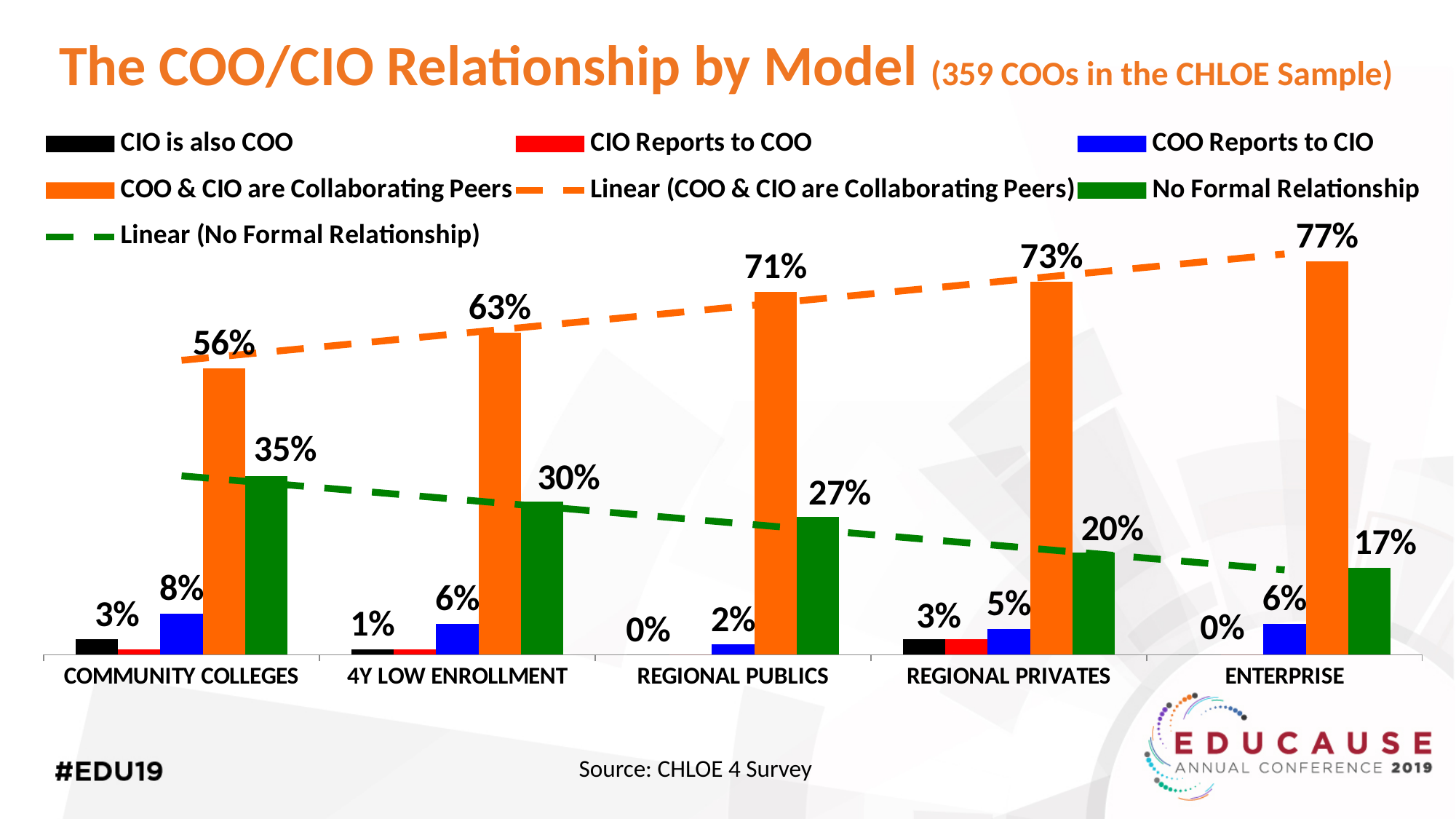
How many entries does the legend list? 7 Which has the larger No Formal Relationship value, 4Y Low Enrollment or Regional Publics? 4Y Low Enrollment What is the value for No Formal Relationship at Community Colleges? 35% What is the value for CIO is also COO at Regional Privates? 3% Which category has the highest value for COO & CIO are Collaborating Peers? Enterprise What is the value for COO & CIO are Collaborating Peers at Enterprise? 77% What kind of chart is shown on the slide? Bar chart What is the difference between the COO & CIO are Collaborating Peers values for Enterprise and Community Colleges? 21 percentage points How many institution categories are shown along the x axis? 5 Which category has the lowest value for No Formal Relationship? Enterprise What is the value for COO Reports to CIO at Community Colleges? 8% Do the COO & CIO are Collaborating Peers values rise or fall from Community Colleges to Enterprise? Rise